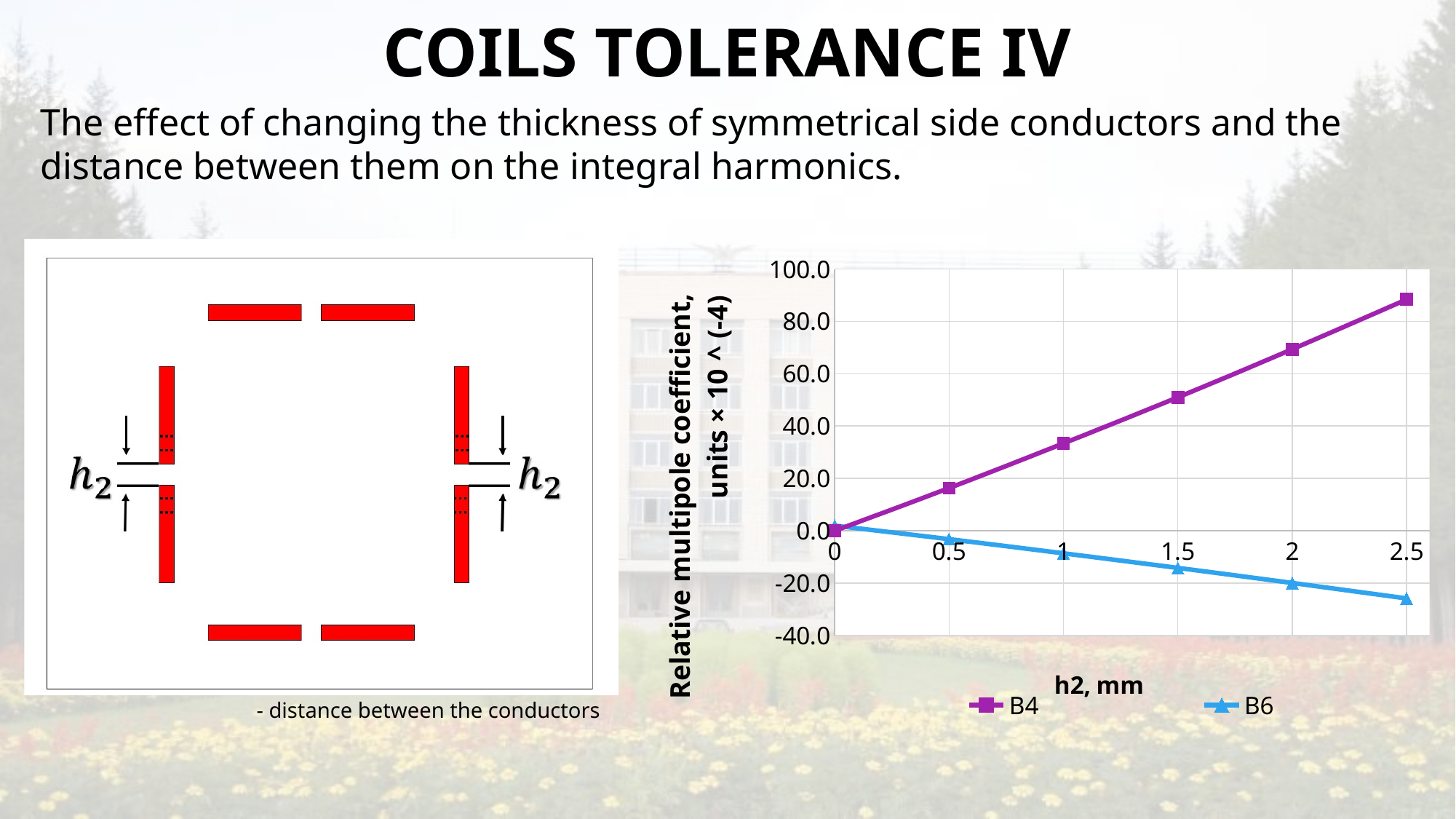
Does the B4 series rise or fall as h2 increases? rises Is the value of B6 at h2 = 2.5 mm greater or less than -20.0? less How many data points are plotted for the B4 series? 6 What are the names of the two series in the chart legend? B4 and B6 At h2 = 2.5 mm, which series has the larger value, B4 or B6? B4 Does the B6 series rise or fall as h2 increases? falls Is the value of B4 at h2 = 1 mm greater or less than 40.0? less How many series does the chart legend list? 2 Is the value of B6 at h2 = 1 mm greater or less than -20.0? greater What is the title of the x axis of the chart? h2, mm What kind of chart is shown on the right of the slide? line chart